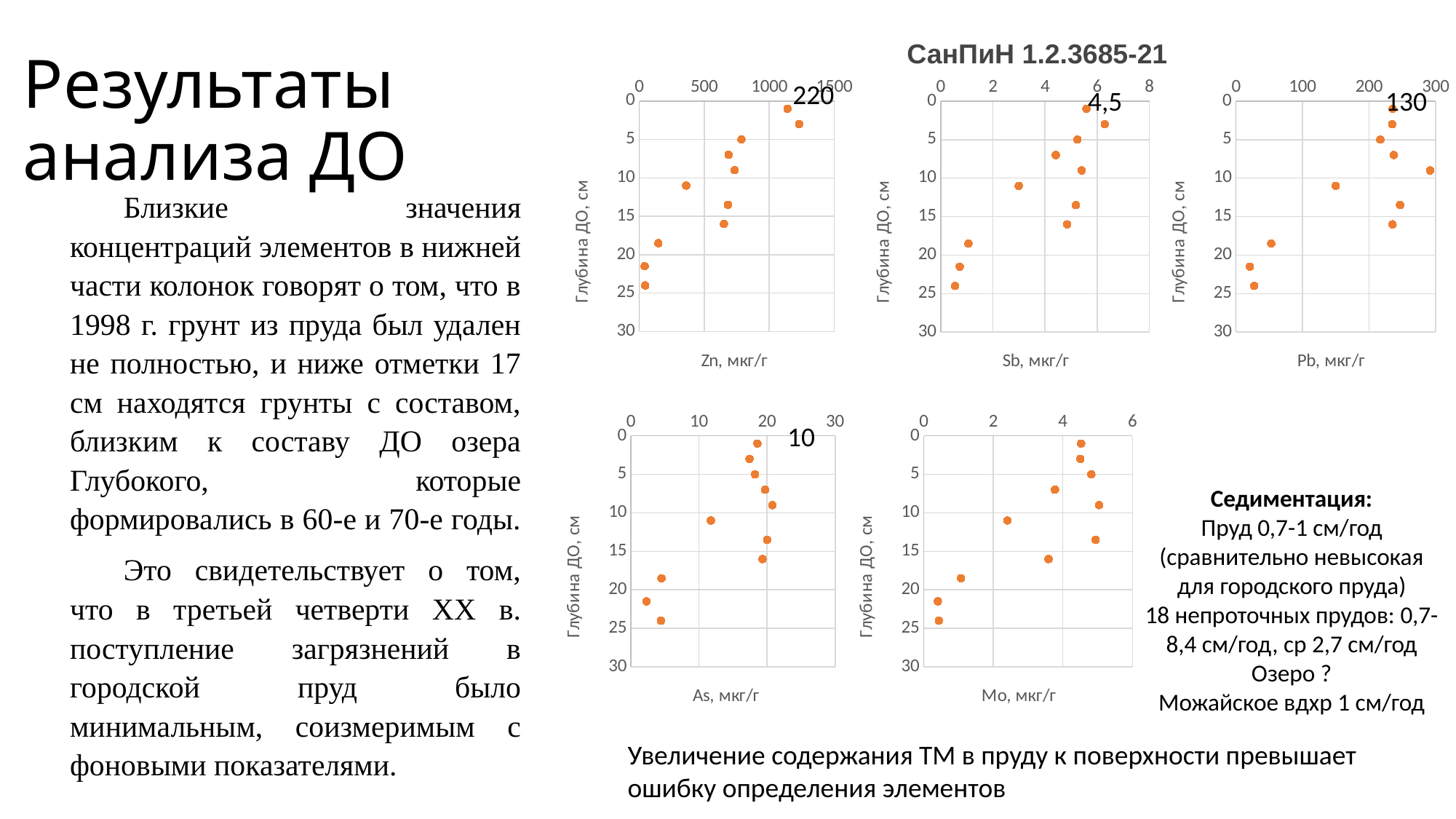
What is the y-axis label of the chart titled 'Sb, мкг/г'? Глубина ДО, см What kind of chart is the chart titled 'Zn, мкг/г'? scatter chart How many charts are shown on the slide? 5 In the chart titled 'Pb, мкг/г', is the value at a depth of 9 cm greater or less than 200? greater In the chart titled 'Pb, мкг/г', is the value at a depth of 24 cm greater or less than 100? less In the chart titled 'Mo, мкг/г', is the value at a depth of 24 cm greater or less than 2? less In the chart titled 'Zn, мкг/г', do the concentrations generally increase or decrease as depth increases? decrease